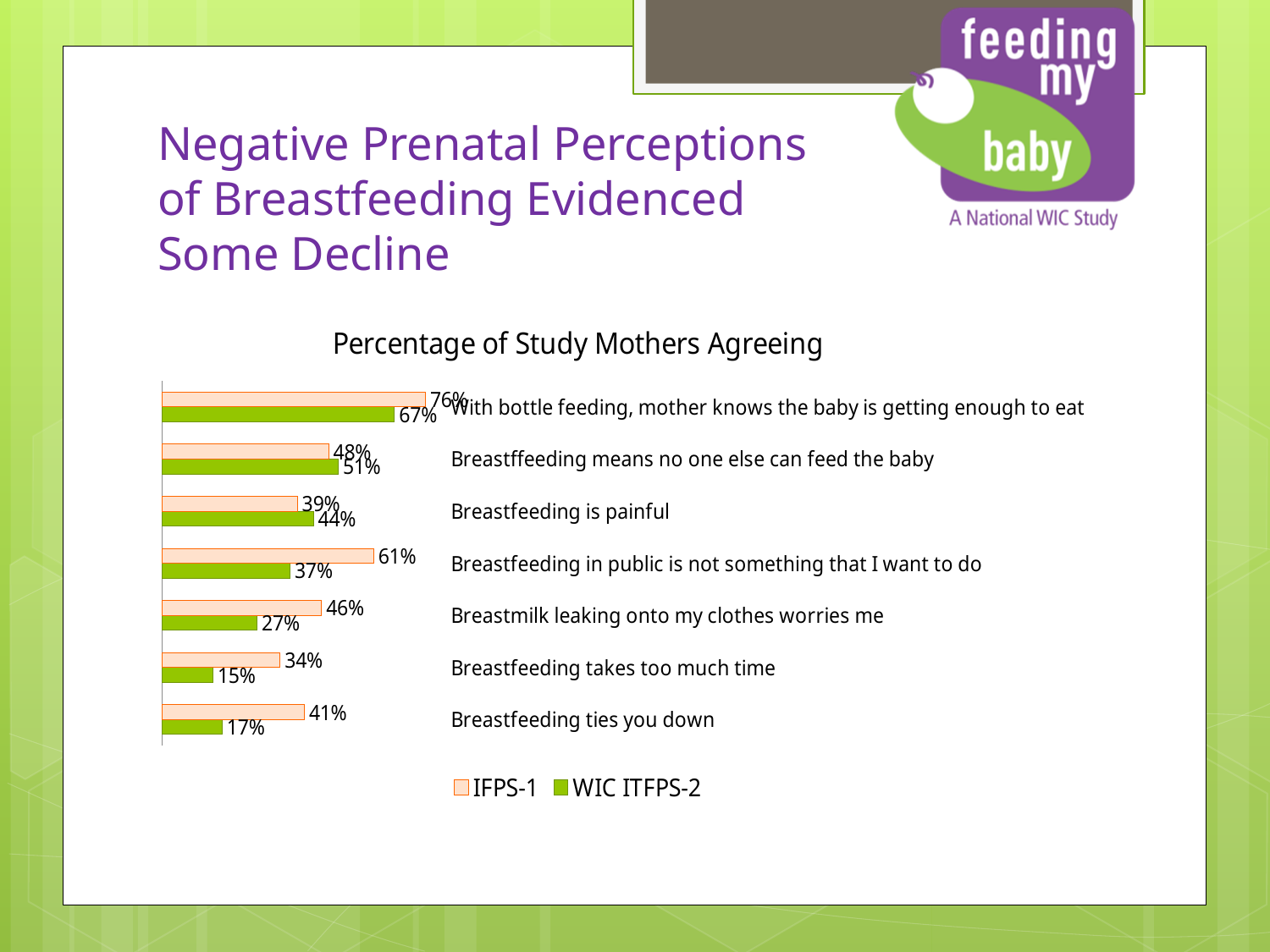
What kind of chart is shown on the slide? Bar chart How many statements are shown in the chart? 7 For 'Breastffeeding means no one else can feed the baby', which series has the larger value, IFPS-1 or WIC ITFPS-2? WIC ITFPS-2 What is the IFPS-1 value for 'Breastfeeding ties you down'? 41% What is the WIC ITFPS-2 value for 'Breastfeeding is painful'? 44% What is the difference between the IFPS-1 and WIC ITFPS-2 values for 'Breastmilk leaking onto my clothes worries me'? 19 percentage points Which statement has the lowest percentage of IFPS-1 mothers agreeing? Breastfeeding takes too much time How many series does the legend list? 2 What percentage of WIC ITFPS-2 mothers agreed that breastfeeding takes too much time? 15% Which statement has the highest percentage of WIC ITFPS-2 mothers agreeing? With bottle feeding, mother knows the baby is getting enough to eat What percentage of IFPS-1 mothers agreed that breastfeeding in public is not something they want to do? 61% What is the title of the chart? Percentage of Study Mothers Agreeing